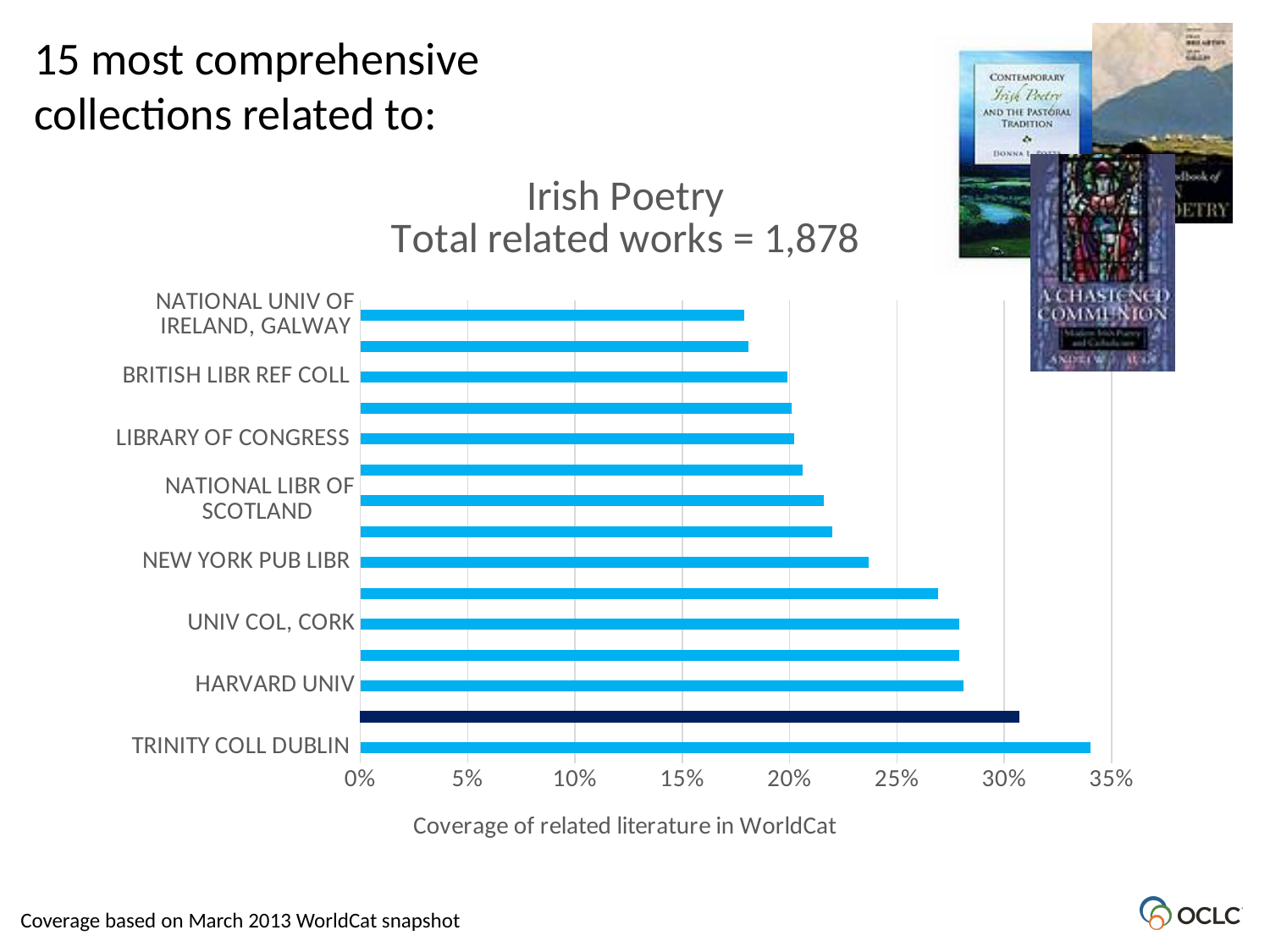
What kind of chart is shown on the slide? bar chart Is the value for NATIONAL UNIV OF IRELAND, GALWAY greater or less than 20%? less How many bars are plotted in the chart? 15 What is the label of the horizontal axis of the chart? Coverage of related literature in WorldCat Which library has the highest coverage of related literature in WorldCat? TRINITY COLL DUBLIN Is the value for TRINITY COLL DUBLIN greater or less than 30%? greater Is the value for NEW YORK PUB LIBR greater or less than 25%? less According to the chart title, what is the total number of related works for Irish Poetry? 1,878 Which has a higher coverage value, NEW YORK PUB LIBR or NATIONAL UNIV OF IRELAND, GALWAY? NEW YORK PUB LIBR Which has a higher coverage value, TRINITY COLL DUBLIN or HARVARD UNIV? TRINITY COLL DUBLIN